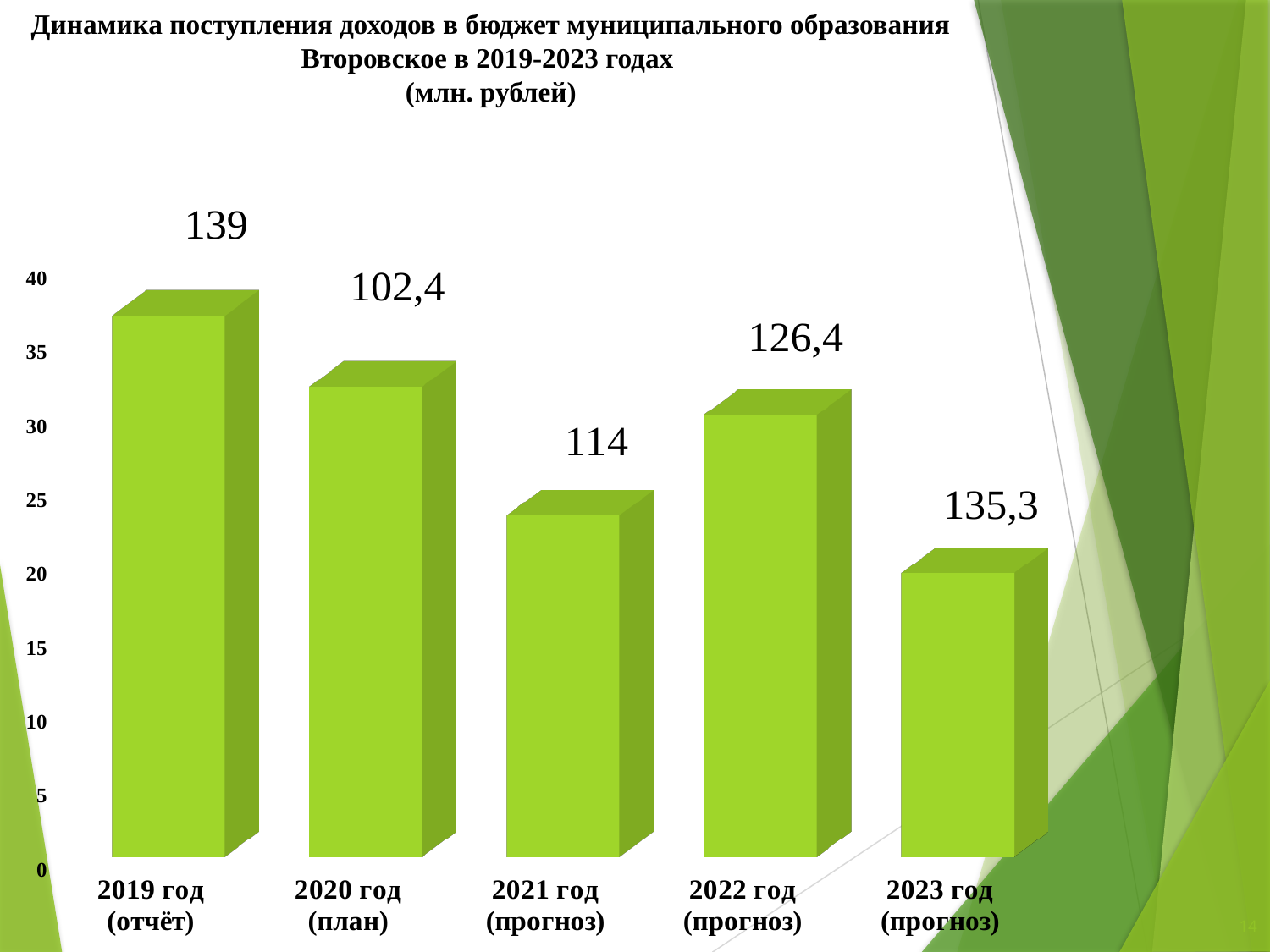
What is the value for 2023 год (прогноз)? 135,3 How many years are shown on the chart? 5 What is the value for 2020 год (план)? 102,4 Which is larger, the value for 2021 год (прогноз) or 2022 год (прогноз)? 2022 год (прогноз) Which year has the highest value? 2019 год (отчёт) What kind of chart is shown on the slide? Bar chart What is the difference between the values for 2019 год (отчёт) and 2020 год (план)? 36,6 In what units are the values on the chart given, according to the title? млн. рублей What is the difference between the values for 2022 год (прогноз) and 2021 год (прогноз)? 12,4 What is the value for 2021 год (прогноз)? 114 What is the value for 2022 год (прогноз)? 126,4 What is the value for 2019 год (отчёт)? 139